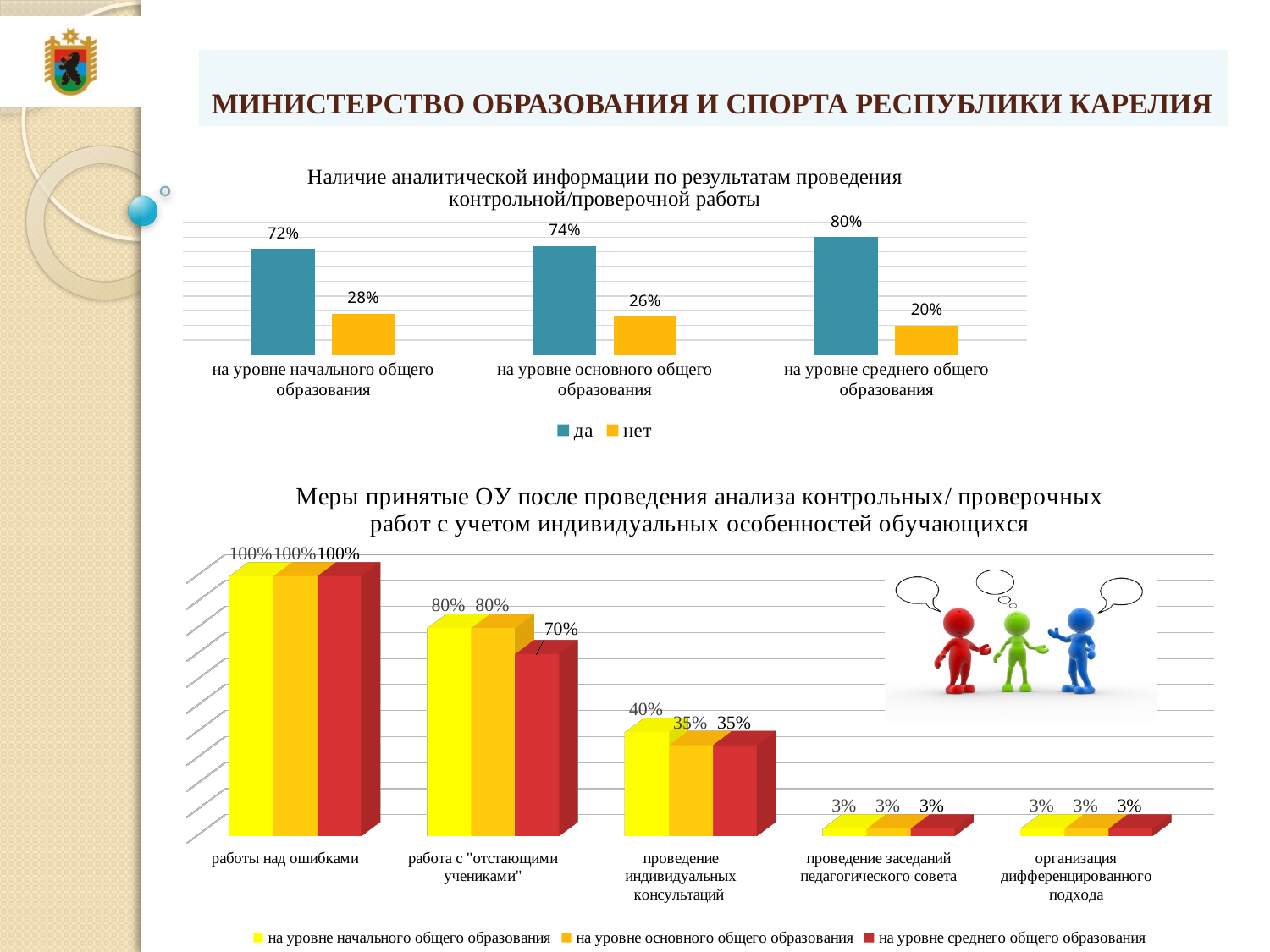
In the top chart 'Наличие аналитической информации...', does the 'да' value rise or fall from the first category to the last? rise In the bottom chart 'Меры принятые ОУ после проведения анализа...', how many series does the legend list? 3 In the top chart 'Наличие аналитической информации...', which category has the highest 'да' value? на уровне среднего общего образования In the bottom chart 'Меры принятые ОУ после проведения анализа...', which category has the highest values across all series? работы над ошибками What kind of chart is the bottom chart 'Меры принятые ОУ после проведения анализа...'? bar chart In the bottom chart 'Меры принятые ОУ после проведения анализа...', how many categories are shown on the x axis? 5 In the top chart 'Наличие аналитической информации...', how many series does the legend list? 2 In the bottom chart 'Меры принятые ОУ после проведения анализа...', what is the value for 'на уровне начального общего образования' in the category 'проведение индивидуальных консультаций'? 40% In the top chart 'Наличие аналитической информации...', what is the value of 'нет' for 'на уровне начального общего образования'? 28% In the top chart 'Наличие аналитической информации по результатам проведения контрольной/проверочной работы', what is the value of 'да' for 'на уровне среднего общего образования'? 80% In the top chart 'Наличие аналитической информации...', what is the difference between 'да' and 'нет' for 'на уровне основного общего образования'? 48% In the bottom chart 'Меры принятые ОУ после проведения анализа...', what is the value for 'на уровне среднего общего образования' in the category 'работа с "отстающими учениками"'? 70%